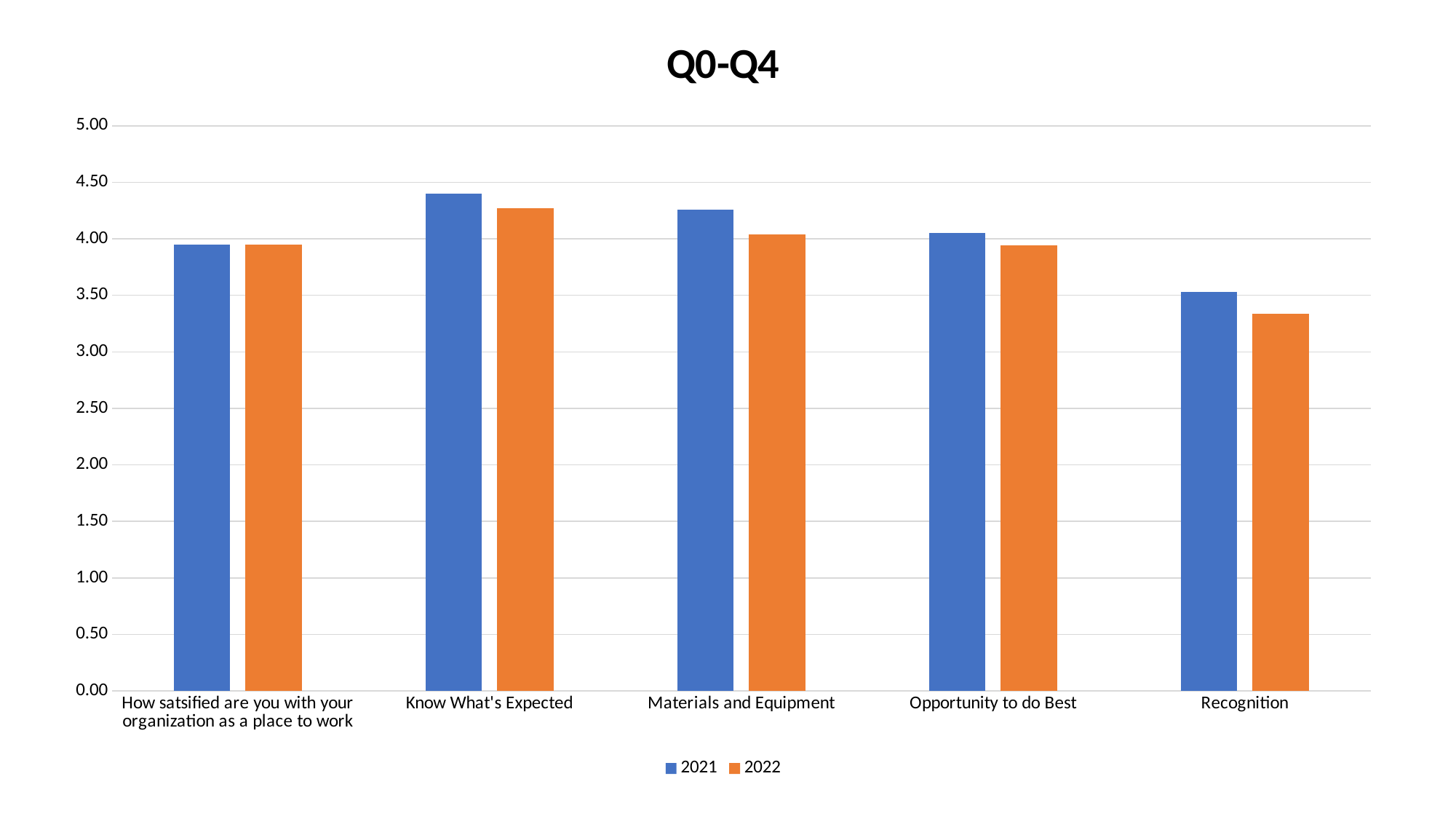
What is the title of the chart? Q0-Q4 Which category has the highest value for 2021? Know What's Expected For Materials and Equipment, which series has the larger value, 2021 or 2022? 2021 How many series does the legend list? 2 Is the 2022 value for Recognition greater or less than 3.50? less Which category has the lowest value for 2021? Recognition For Recognition, which series has the larger value, 2021 or 2022? 2021 Which category has the lowest value for 2022? Recognition Is the 2021 value for Know What's Expected greater or less than 4.00? greater How many categories are shown on the x axis? 5 What kind of chart is shown on the slide? bar chart Is the 2021 value for Materials and Equipment greater or less than 4.00? greater